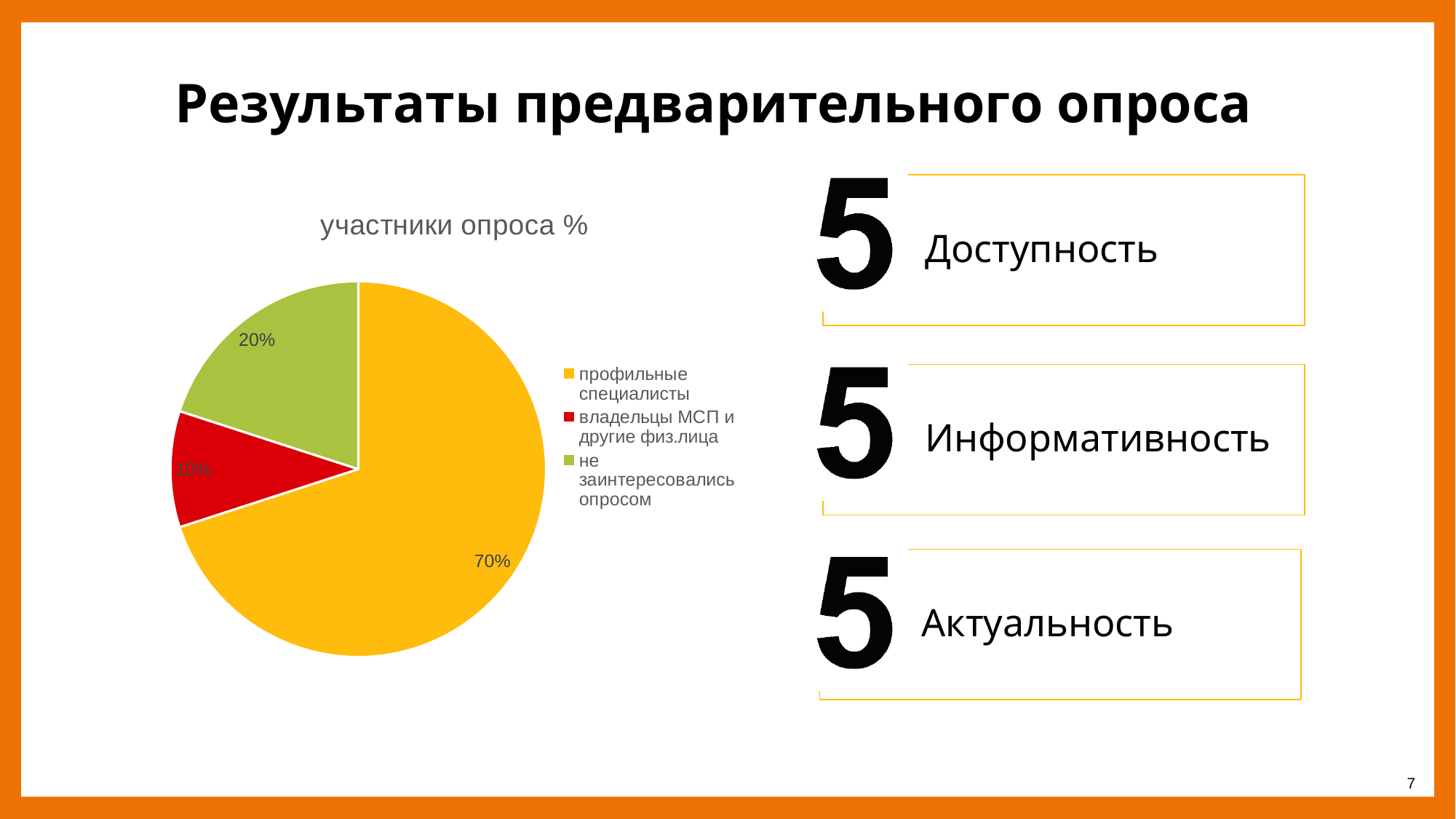
How many entries does the legend list? 3 What kind of chart is shown on the slide? pie chart How many slices does the pie chart have? 3 What is the difference between the share for "профильные специалисты" and the share for "не заинтересовались опросом"? 50% Which category has the largest slice of the pie? профильные специалисты What share of the pie is labelled "профильные специалисты"? 70% Which is larger: the share for "не заинтересовались опросом" or the share for "владельцы МСП и другие физ.лица"? не заинтересовались опросом What share of the pie is labelled "владельцы МСП и другие физ.лица"? 10% Which category has the smallest slice of the pie? владельцы МСП и другие физ.лица What is the title of the chart? участники опроса % What colour is the slice for "владельцы МСП и другие физ.лица"? red What share of the pie is labelled "не заинтересовались опросом"? 20%